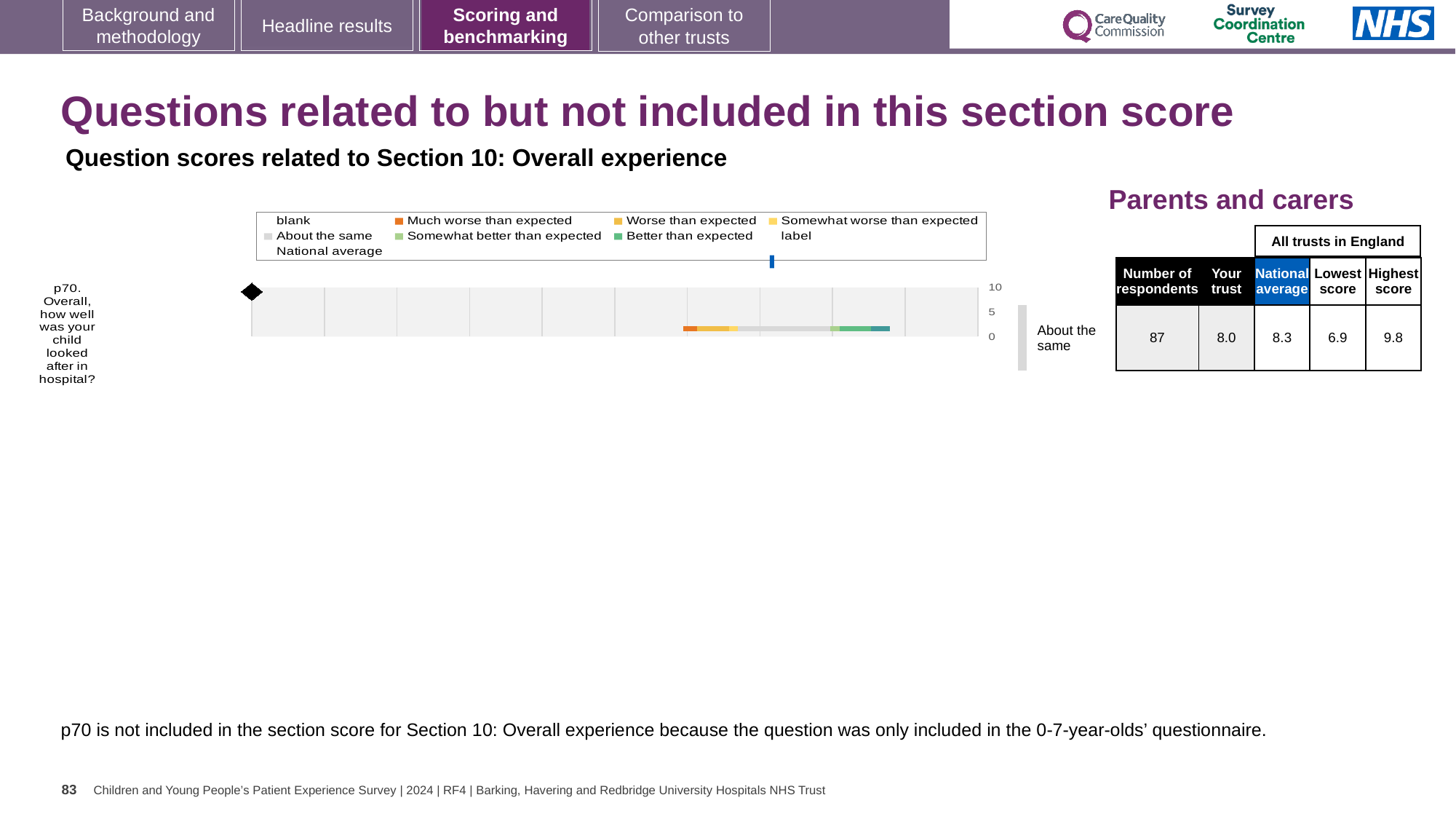
What kind of chart is shown on the slide? bar chart In the table next to the chart, what is the Highest score among all trusts in England for p70? 9.8 For p70, what is the difference between the Highest score and the Lowest score among all trusts in England? 2.9 For p70, which is larger: the 'Your trust' score or the National average? National average In the table next to the chart, what is the National average score for p70? 8.3 In the table next to the chart, what is the Lowest score among all trusts in England for p70? 6.9 How many entries does the chart legend list? 9 What is the highest tick value shown on the chart's axis? 10 How many questions (categories) are plotted in the chart? 1 What benchmark category label is shown to the right of the chart for p70? About the same Which question is plotted in the chart? p70. Overall, how well was your child looked after in hospital? In the table next to the chart, what is the 'Your trust' score for p70? 8.0